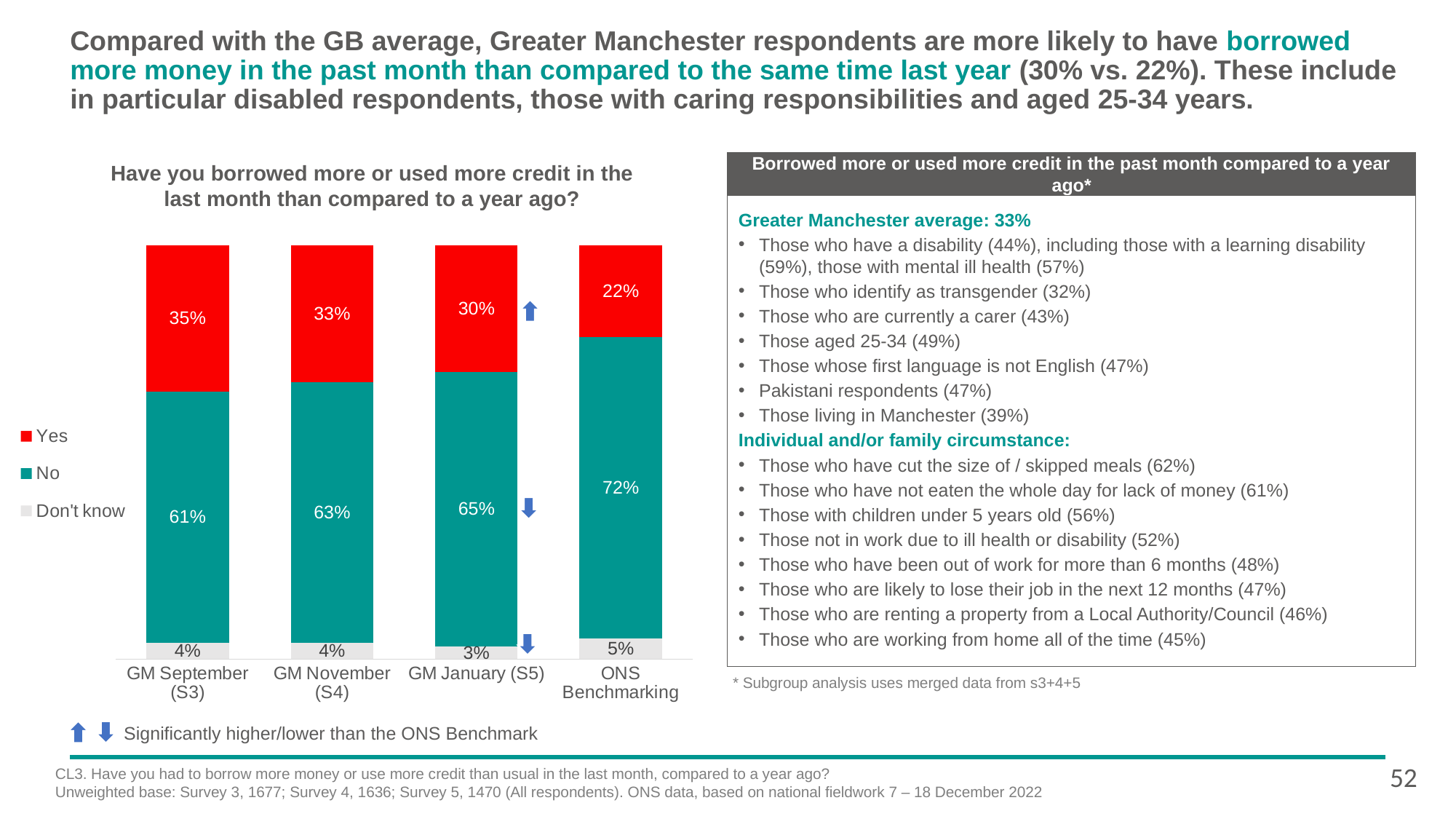
Which category has the highest Yes value? GM September (S3) What kind of chart is shown on the slide? Stacked bar chart Which category has the lowest Yes value? ONS Benchmarking Does the Yes value rise or fall across the three GM surveys from September (S3) to January (S5)? Fall Which colour represents the Yes series in the chart? Red Which is larger, the No value for GM November (S4) or for GM January (S5)? GM January (S5) What is the Don't know value for GM January (S5)? 3% How many categories are shown on the x axis of the chart? 4 What percentage of GM September (S3) respondents answered Yes? 35% How many series does the chart legend list? 3 What is the difference between the Yes value for GM January (S5) and ONS Benchmarking? 8 percentage points What percentage of ONS Benchmarking respondents answered No? 72%